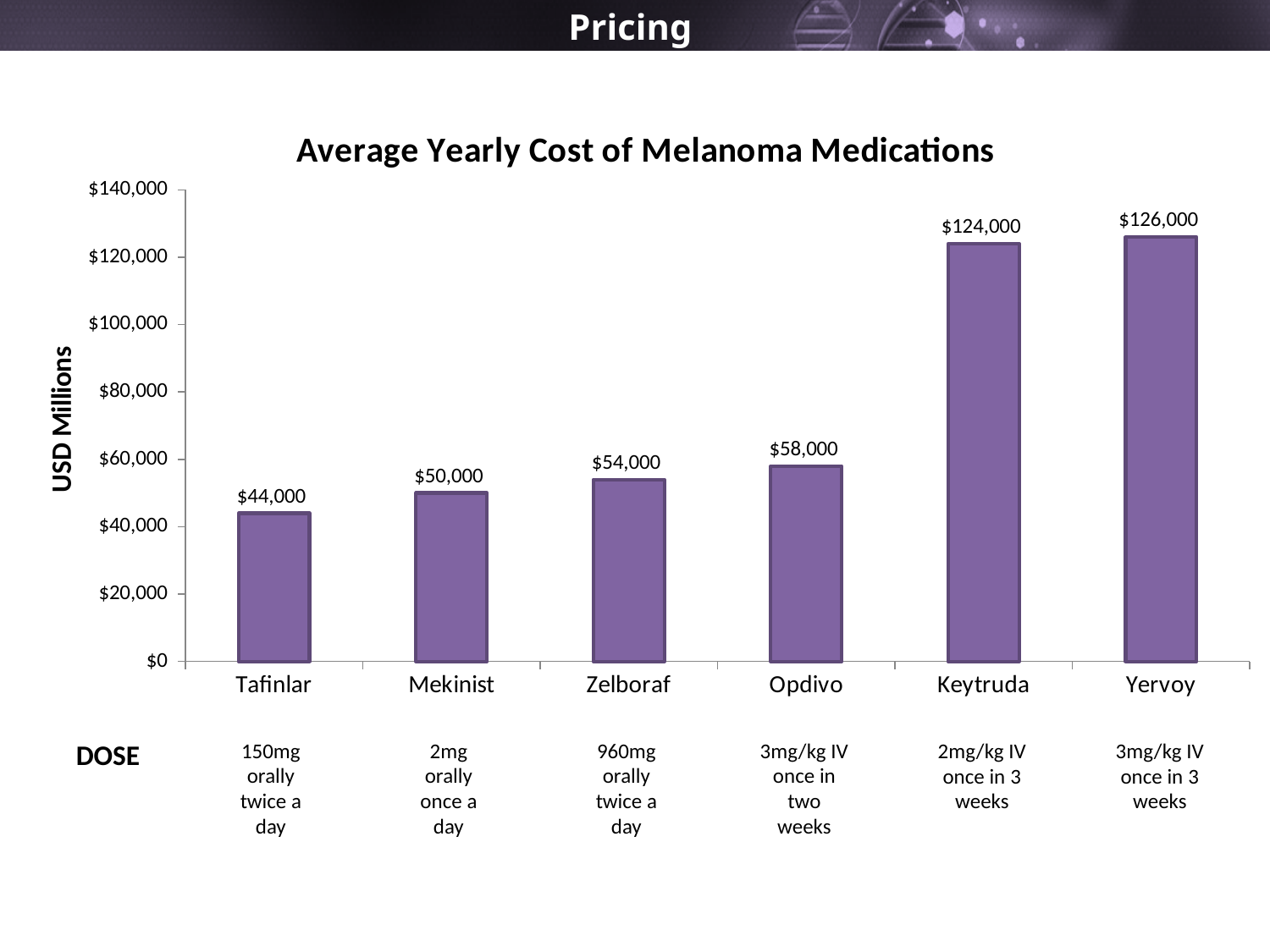
What kind of chart is shown on the slide? Bar chart What is the difference in average yearly cost between Zelboraf and Mekinist? $4,000 Is the value for Mekinist greater or less than $60,000? less Which medication has the lowest average yearly cost? Tafinlar What is the difference in average yearly cost between Yervoy and Tafinlar? $82,000 What is the average yearly cost shown for Keytruda? $124,000 Which medication has the highest average yearly cost? Yervoy What is the average yearly cost shown for Tafinlar? $44,000 What is the average yearly cost shown for Opdivo? $58,000 What is the title of the chart? Average Yearly Cost of Melanoma Medications Which has a higher average yearly cost, Opdivo or Zelboraf? Opdivo How many medications are shown in the chart? 6